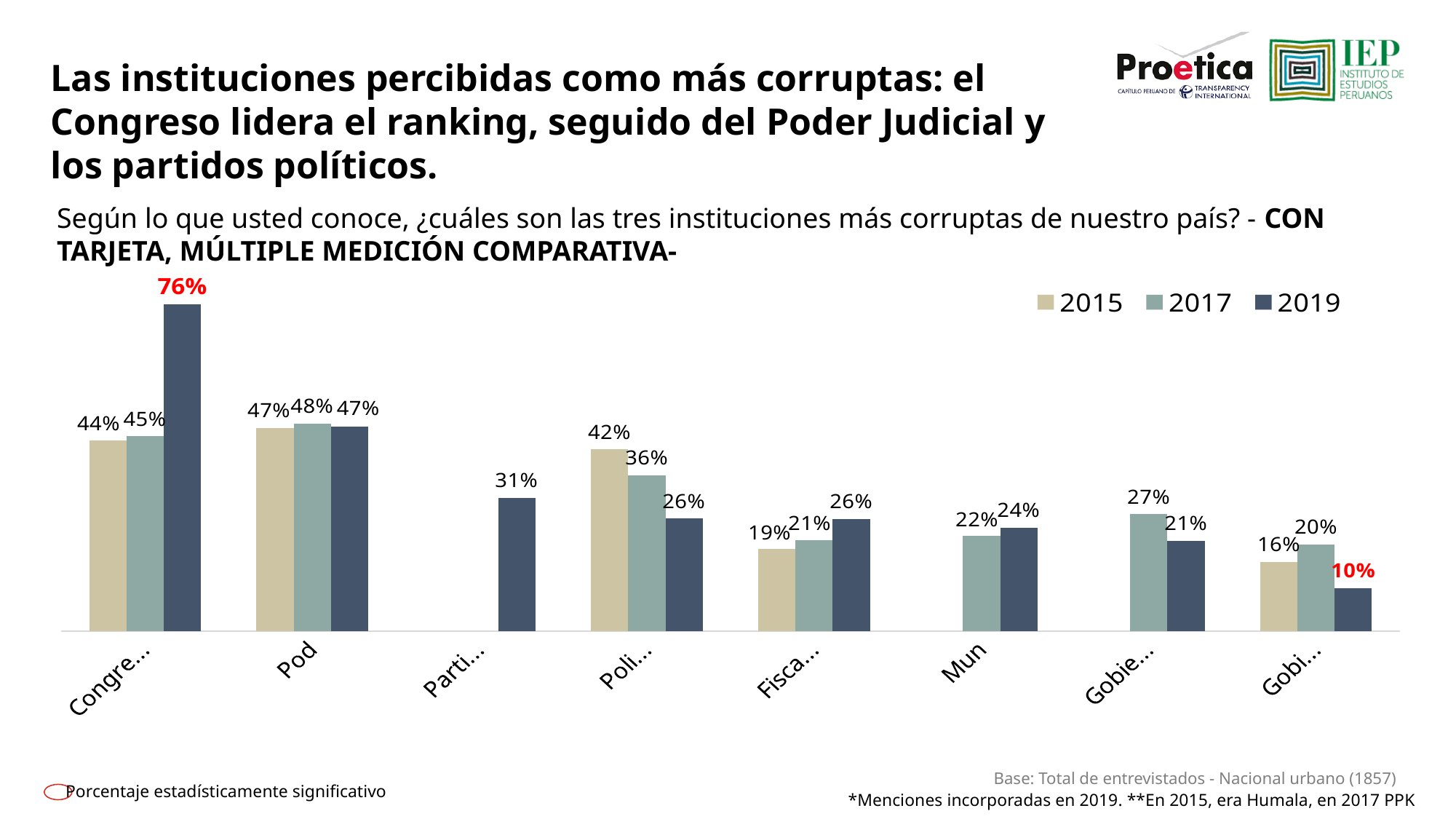
How many series does the legend list? 3 How many categories are shown on the x axis? 8 Which category has the highest 2019 value? Congre... (the first category) What is the 2019 value for the category labelled "Mun"? 24% For the category labelled "Poli...", do the values rise or fall from 2015 to 2019? Fall What is the 2019 value for the category labelled "Parti..."? 31% What kind of chart is shown on the slide? Bar chart Which category has the lowest 2019 value? Gobi... (the last category) What is the 2017 value for the category labelled "Pod"? 48% What is the 2019 value for the first category (labelled "Congre...")? 76% By how many percentage points did the value for the first category ("Congre...") rise from 2015 to 2019? 32 percentage points For the category labelled "Poli...", which year has the larger value, 2015 or 2017? 2015